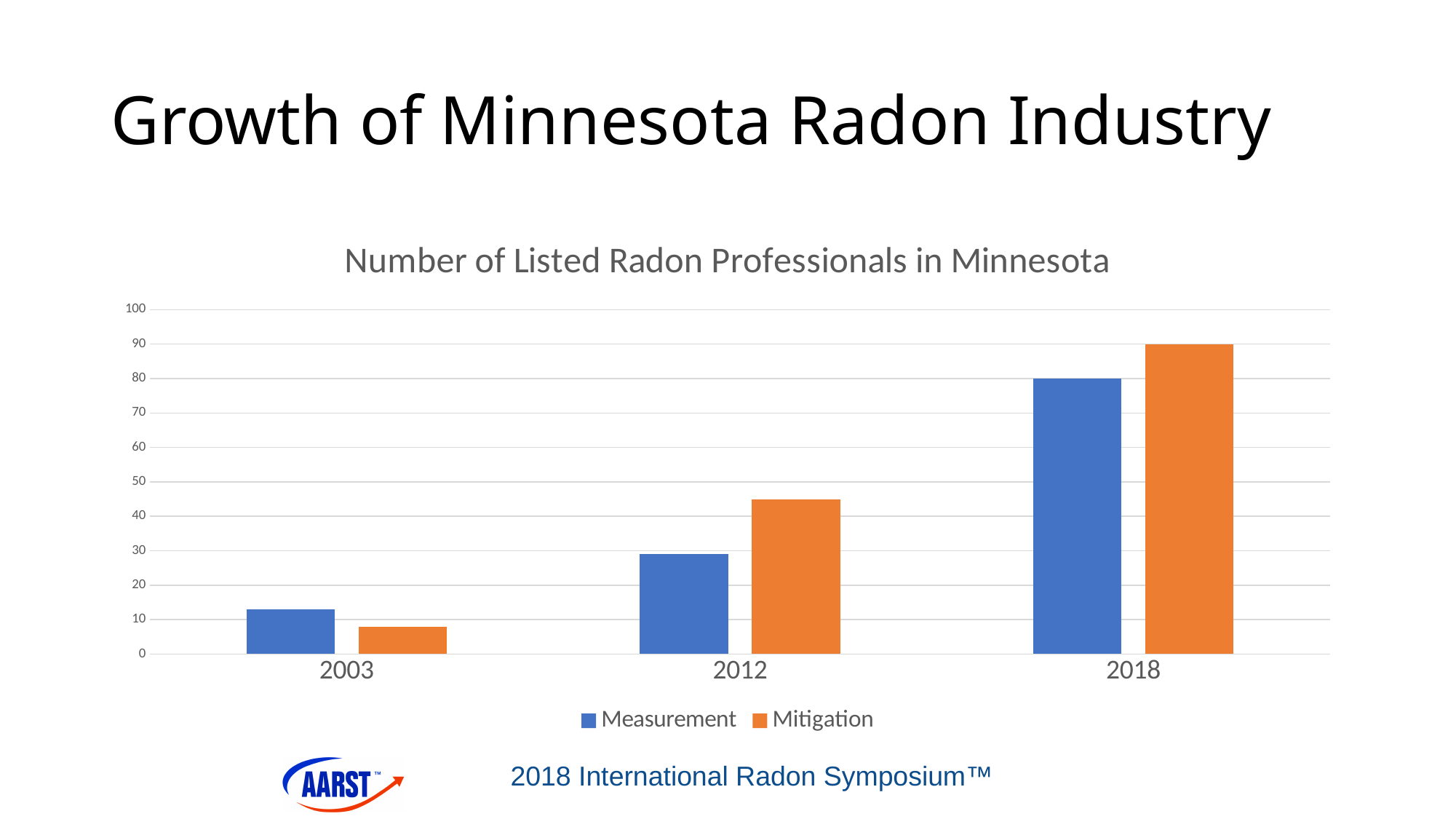
What is the Mitigation value for 2018? 90 In 2003, which is larger, Measurement or Mitigation? Measurement What is the Measurement value for 2018? 80 Which year has the highest Mitigation value? 2018 What kind of chart is shown on the slide? bar chart Is the Mitigation value for 2012 greater or less than 40? greater How many years are shown on the x axis? 3 Do the Mitigation values rise or fall from 2003 to 2018? rise What is the title of the chart? Number of Listed Radon Professionals in Minnesota How many series does the legend list? 2 Which year has the lowest Measurement value? 2003